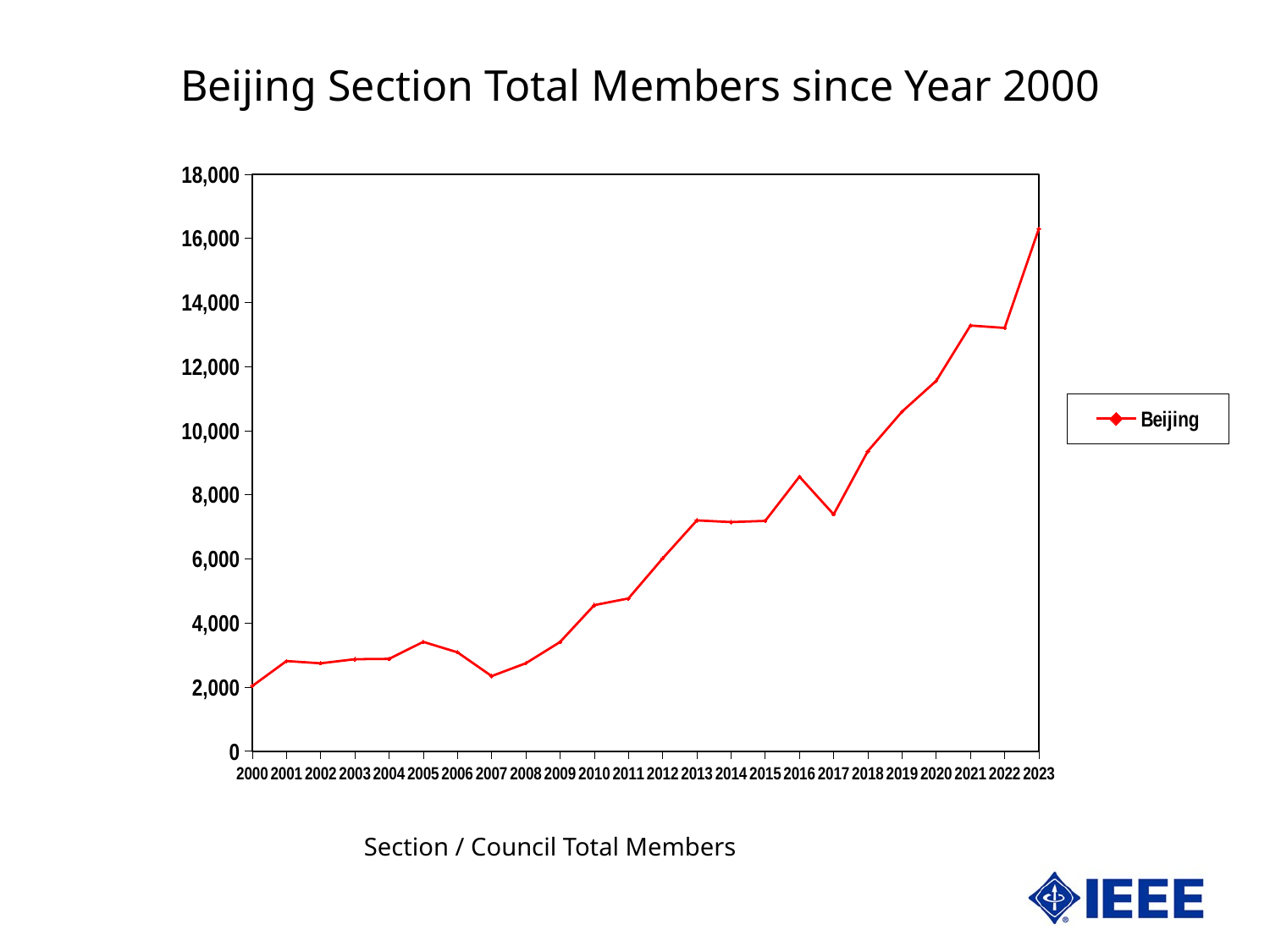
How many series does the legend list? 1 In which year is the number of Beijing members lowest? 2000 What kind of chart is shown on the slide? line chart Which year has the larger value, 2016 or 2017? 2016 Is the value for 2007 greater or less than 4,000? less In which year is the number of Beijing members highest? 2023 Is the value for 2016 greater or less than 8,000? greater Is the value for 2023 greater or less than 16,000? greater What is the name of the series shown in the legend? Beijing Overall, do the values rise or fall from 2000 to 2023? rise What is the title of the chart? Beijing Section Total Members since Year 2000 How many years are plotted along the x axis? 24